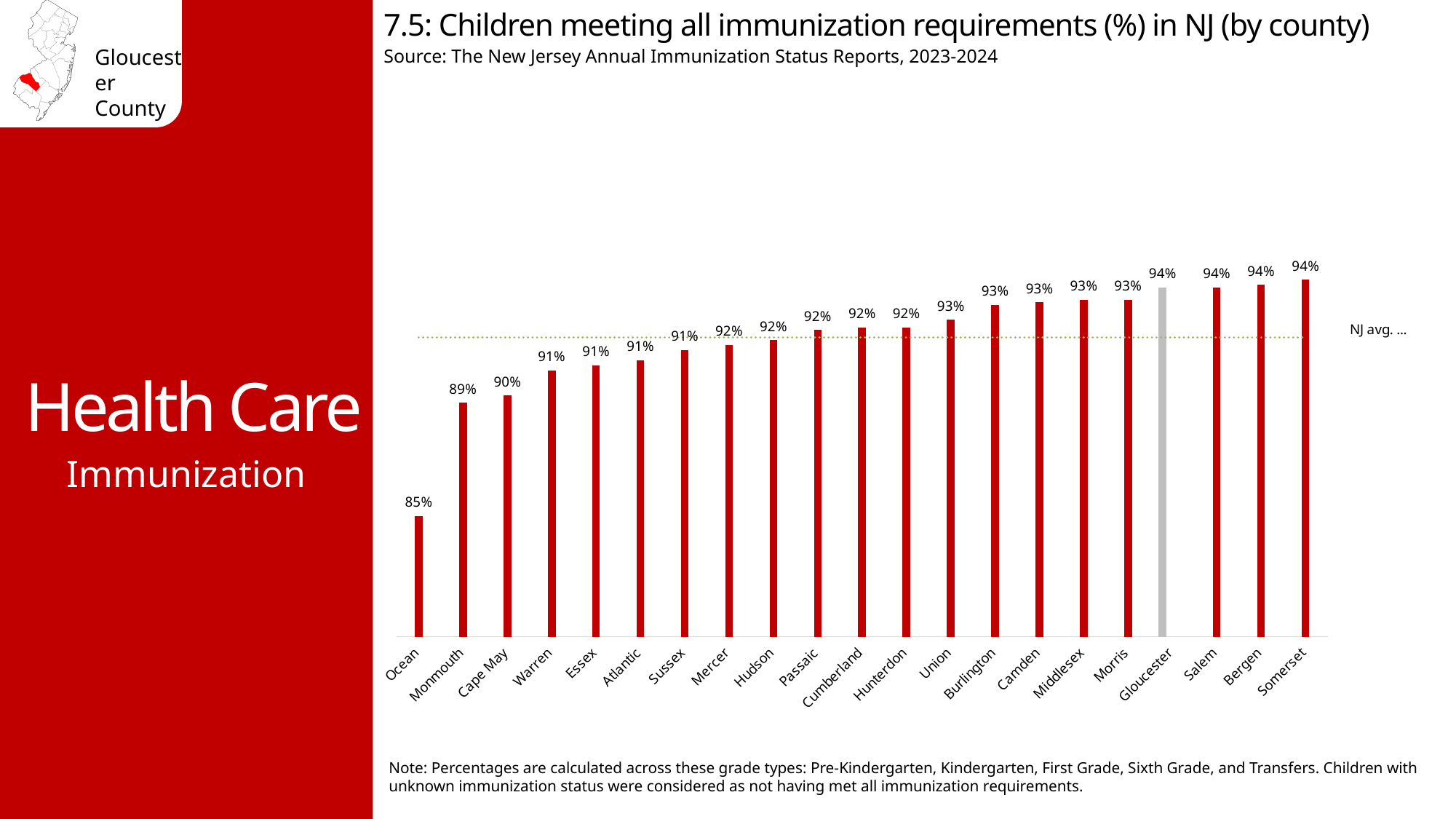
Do the values generally rise or fall from left to right across the counties? Rise What is the value shown for Ocean County? 85% What is the difference in percentage points between Gloucester County and Ocean County? 9 percentage points What kind of chart is shown on the slide? Bar chart What is the value for Cape May? 90% How many counties are shown on the chart? 21 Which has a higher value, Monmouth or Morris? Morris Which county's bar is coloured grey instead of red? Gloucester Which county has the lowest percentage of children meeting all immunization requirements? Ocean What percentage is shown for Hudson County? 92% What percentage is shown for Monmouth County? 89% What percentage of children in Gloucester County met all immunization requirements? 94%